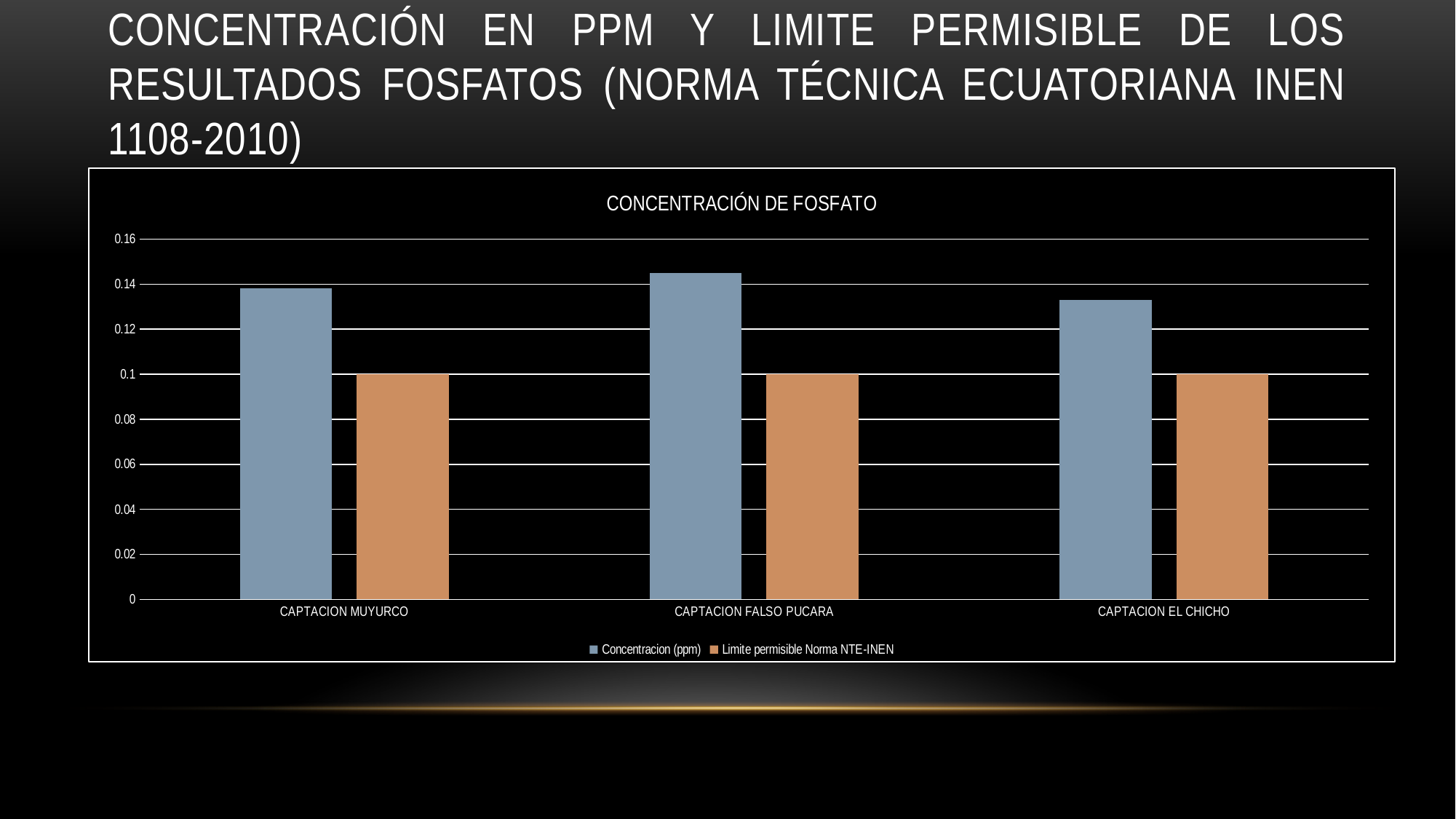
What is the value of 'Limite permisible Norma NTE-INEN' for CAPTACION MUYURCO? 0.1 What is the title of the chart? CONCENTRACIÓN DE FOSFATO What kind of chart is shown on the slide? bar chart Which series is shown in orange in the chart? Limite permisible Norma NTE-INEN How many series does the chart legend list? 2 For CAPTACION FALSO PUCARA, which is larger: 'Concentracion (ppm)' or 'Limite permisible Norma NTE-INEN'? Concentracion (ppm) How many categories (captaciones) are shown on the x axis of the chart? 3 Is the 'Concentracion (ppm)' value for CAPTACION FALSO PUCARA greater or less than 0.14? greater Which captación has the highest 'Concentracion (ppm)' value? CAPTACION FALSO PUCARA Is the 'Concentracion (ppm)' value for CAPTACION EL CHICHO greater or less than 0.14? less What is the value of 'Limite permisible Norma NTE-INEN' for CAPTACION EL CHICHO? 0.1 Is the 'Concentracion (ppm)' value for CAPTACION MUYURCO greater or less than 0.12? greater